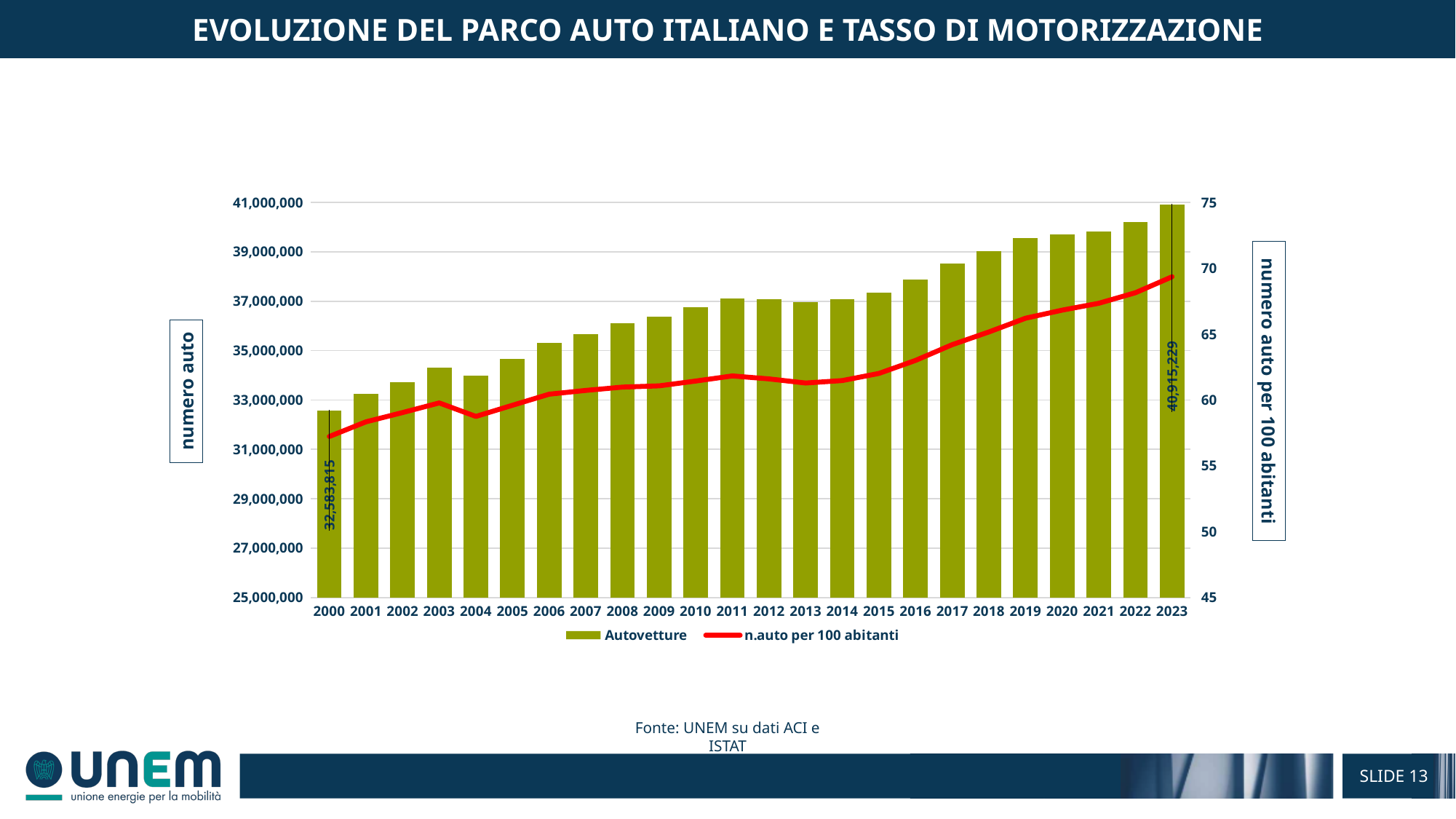
How many years are shown on the x axis? 24 Which year has the lowest Autovetture bar? 2000 What is the value of Autovetture for 2000? 32,583,815 What kind of chart is shown on the slide? Bar chart with a line Do the Autovetture values generally rise or fall from 2000 to 2023? Rise Which year has the larger Autovetture value, 2005 or 2010? 2010 How many series does the legend list? 2 Is the n.auto per 100 abitanti value for 2000 greater or less than 60? less Is the Autovetture value for 2010 greater or less than 35,000,000? greater Which year has the highest Autovetture bar? 2023 What is the difference between the Autovetture values for 2023 and 2000? 8,331,414 What is the value of Autovetture for 2023? 40,915,229